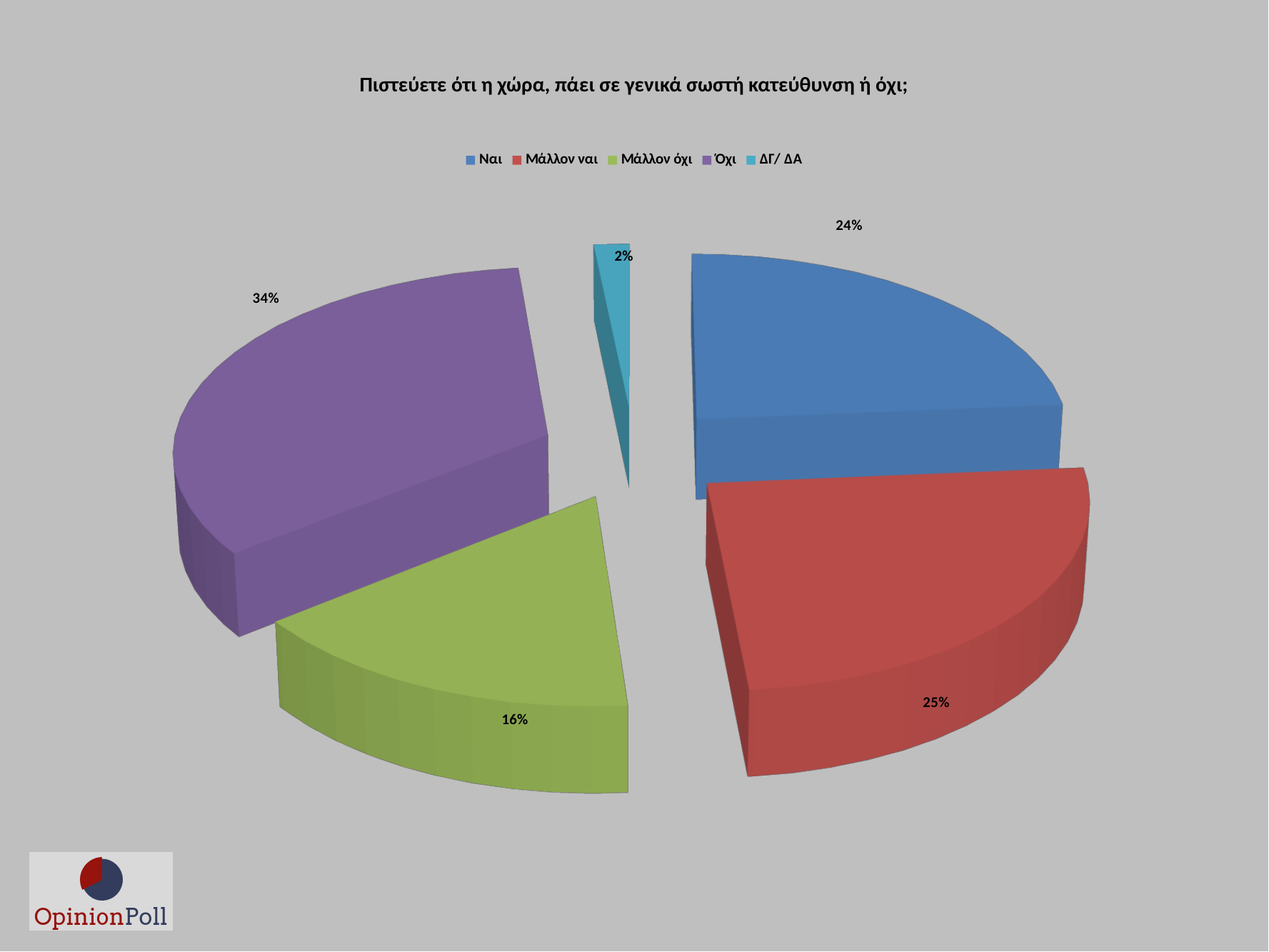
Which is larger, the share for "Μάλλον όχι" or the share for "Μάλλον ναι"? Μάλλον ναι What type of chart is shown on the slide? Pie chart What percentage of respondents answered "Μάλλον όχι"? 16% What is the difference in percentage points between "Όχι" and "Ναι"? 10 What percentage of respondents answered "Μάλλον ναι"? 25% How many categories does the legend list? 5 What percentage of respondents answered "ΔΓ/ ΔΑ"? 2% Which response has the largest share of the pie? Όχι What percentage of respondents answered "Ναι"? 24% Which response has the smallest share of the pie? ΔΓ/ ΔΑ What percentage of respondents answered "Όχι"? 34% Which colour represents "Όχι" in the pie chart? Purple